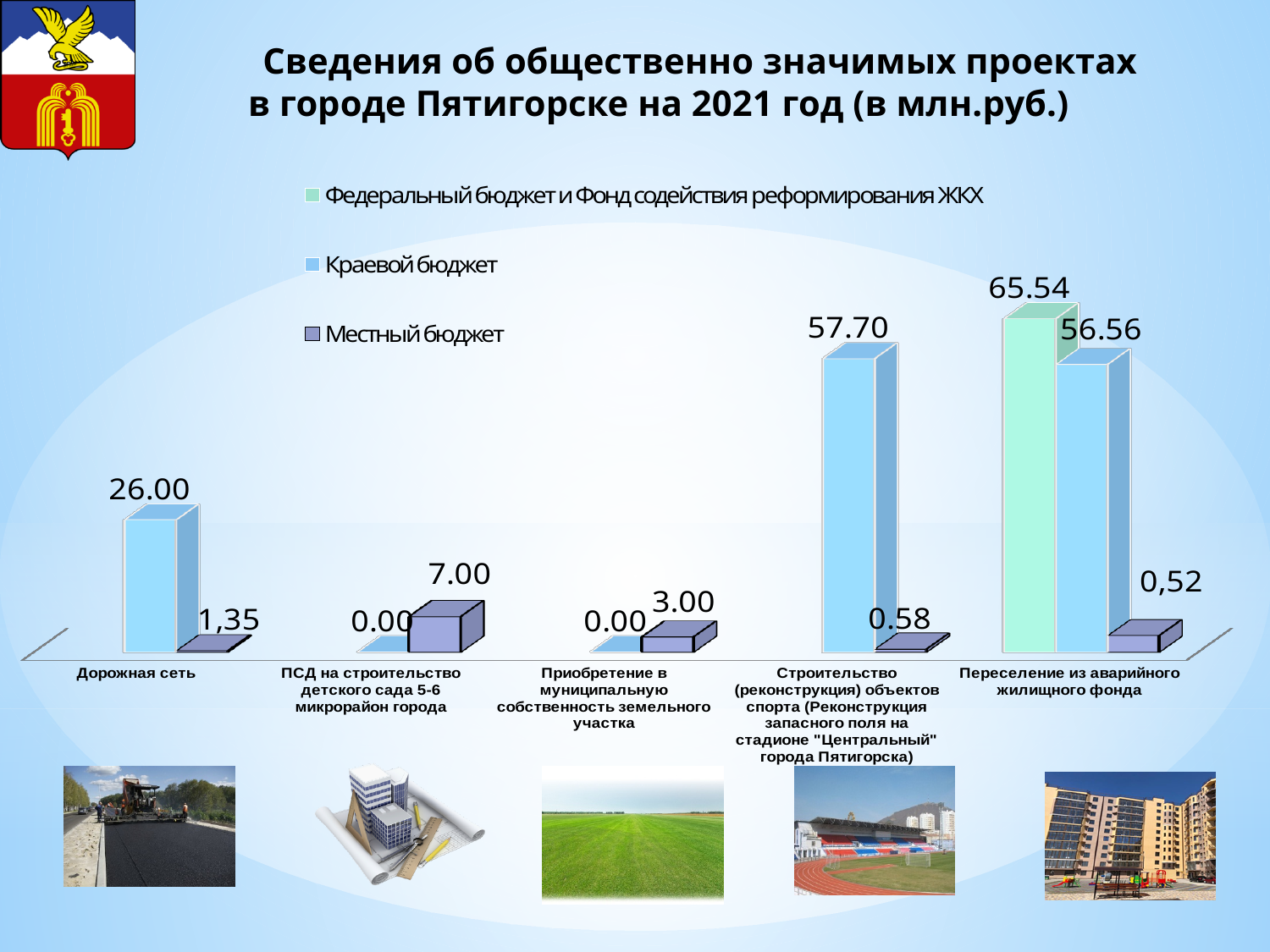
What is the difference between the Краевой бюджет values for Строительство (реконструкция) объектов спорта and Дорожная сеть? 31.70 How many series does the legend list? 3 What is the value of Краевой бюджет for Дорожная сеть? 26.00 What is the value of Краевой бюджет for Строительство (реконструкция) объектов спорта? 57.70 Which is larger for Переселение из аварийного жилищного фонда: Федеральный бюджет и Фонд содействия реформирования ЖКХ or Краевой бюджет? Федеральный бюджет и Фонд содействия реформирования ЖКХ What is the value of Федеральный бюджет и Фонд содействия реформирования ЖКХ for Переселение из аварийного жилищного фонда? 65.54 What kind of chart is shown on the slide? Bar chart What is the value of Местный бюджет for ПСД на строительство детского сада 5-6 микрорайон города? 7.00 What is the value of Местный бюджет for Дорожная сеть? 1,35 Which category has the highest value for Краевой бюджет? Строительство (реконструкция) объектов спорта Which category has the highest value for Местный бюджет? ПСД на строительство детского сада 5-6 микрорайон города How many categories are shown on the x axis? 5